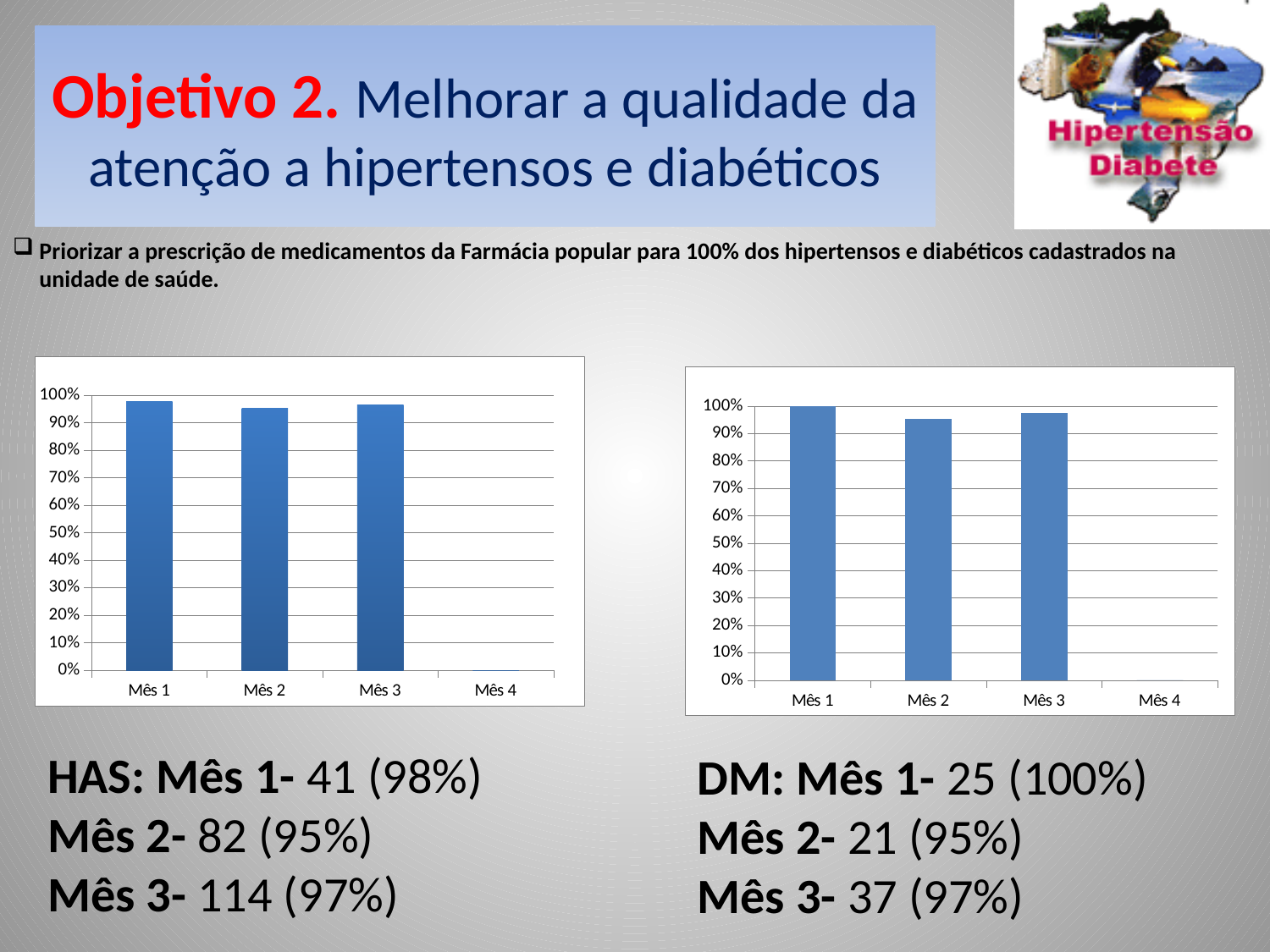
According to the text below the left chart, what percentage is given for HAS in Mês 3? 97% How many categories are shown on the x axis of the right chart? 4 In the right chart, is the value for Mês 3 greater or less than 50%? greater According to the text below the right chart, what percentage is given for DM in Mês 2? 95% In the left chart, is the value for Mês 2 greater or less than 90%? greater In the right chart, which of Mês 1, Mês 2 and Mês 3 has the lowest bar? Mês 2 In the right chart, is the bar for Mês 1 taller or shorter than the bar for Mês 2? taller In the left chart, is the bar for Mês 1 taller or shorter than the bar for Mês 2? taller In the left chart, which of Mês 1, Mês 2 and Mês 3 has the lowest bar? Mês 2 What kind of chart is the left chart on the slide? bar chart In the right chart, which month has the highest bar? Mês 1 In the right chart, what value does the bar for Mês 1 reach? 100%